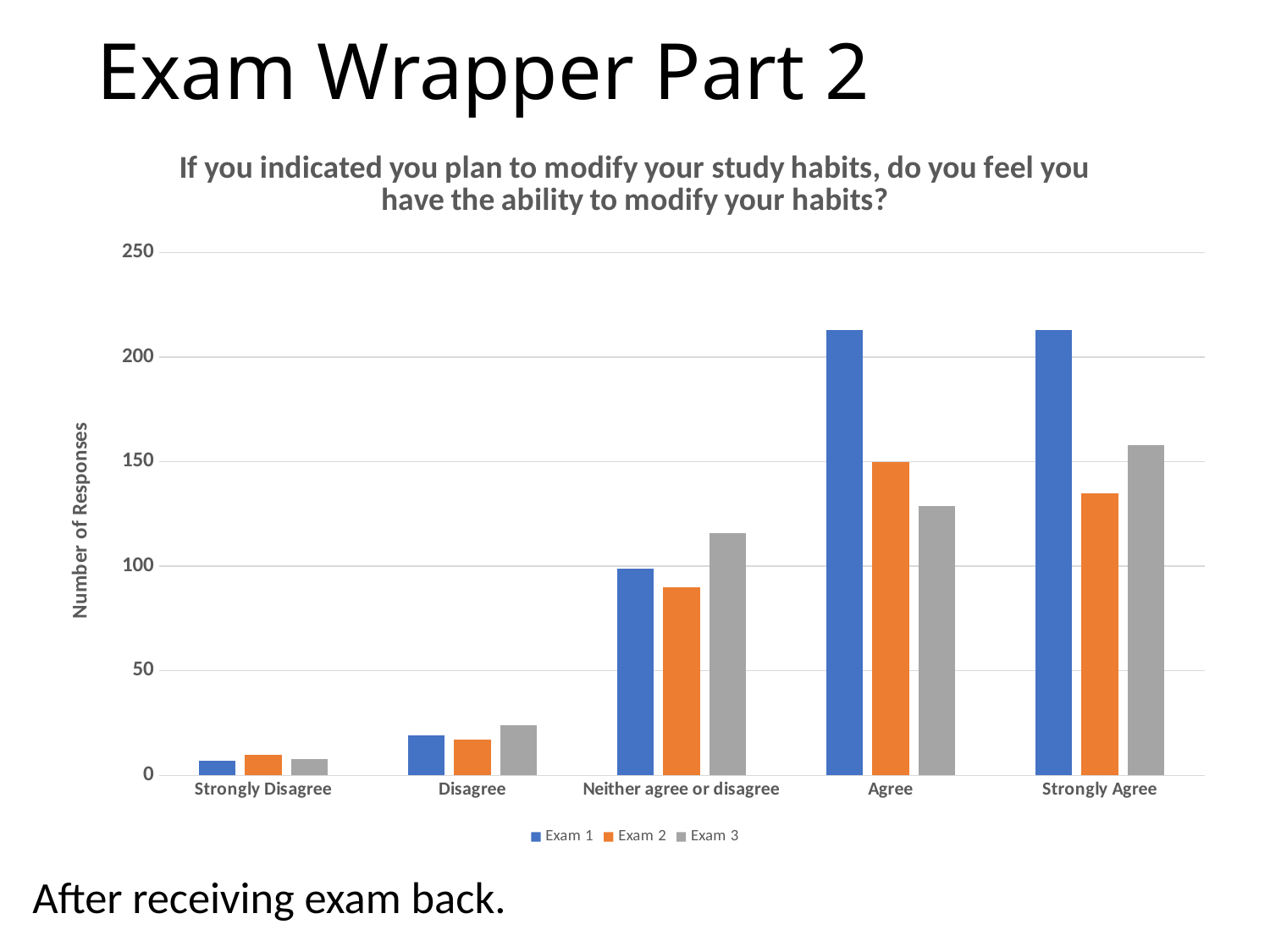
Is the Exam 3 value for Agree greater or less than 150? less What is the label of the y axis? Number of Responses What kind of chart is shown on the slide? bar chart How many series does the legend list? 3 Is the Exam 3 value for Neither agree or disagree greater or less than 100? greater Is the Exam 1 value for Agree greater or less than 200? greater Which response category has the highest Exam 2 value? Agree How many response categories are shown along the x axis? 5 Which response category has the highest Exam 3 value? Strongly Agree For the Agree category, which is larger: the Exam 1 value or the Exam 3 value? Exam 1